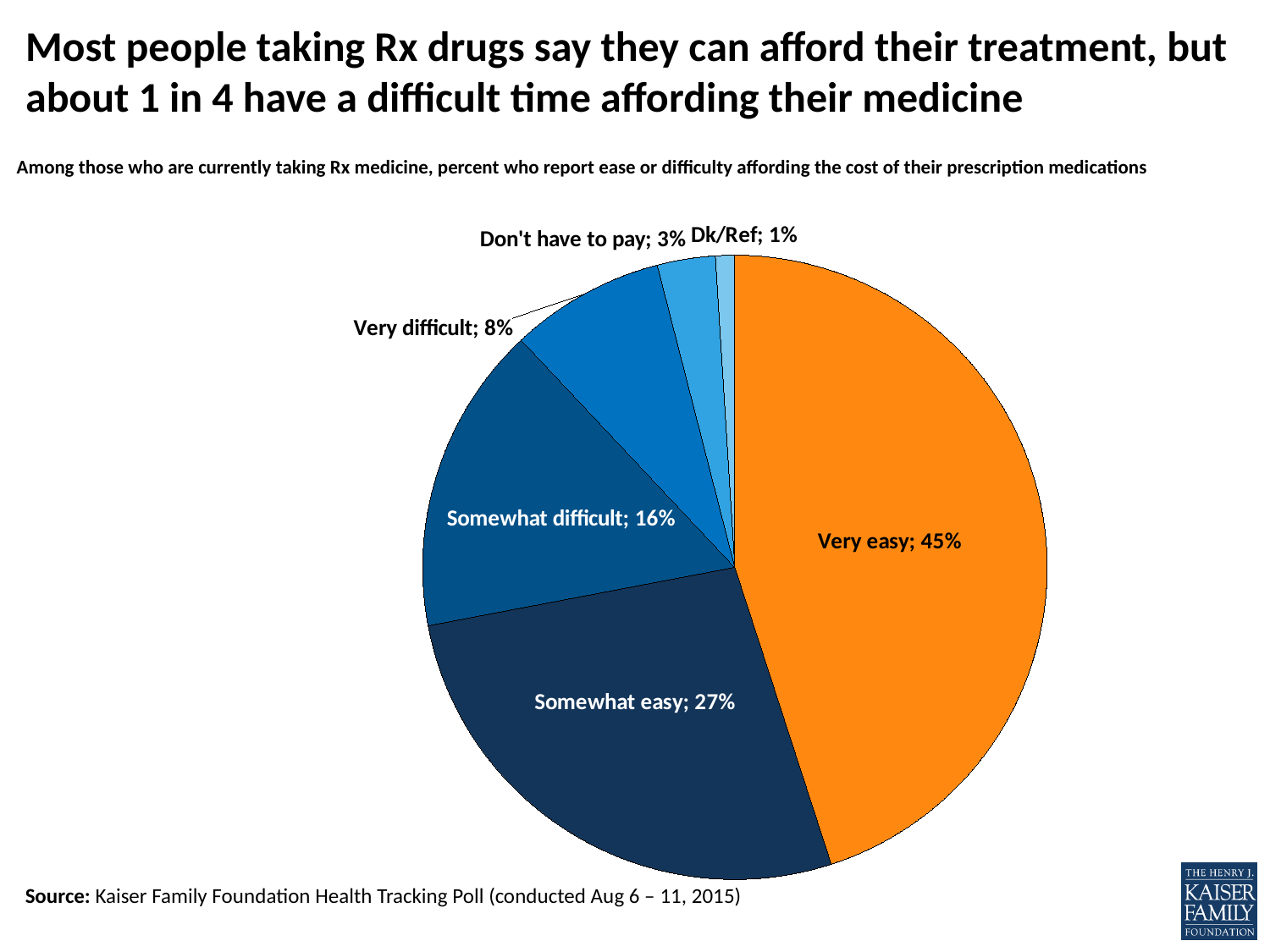
What is the combined share of the 'Somewhat difficult' and 'Very difficult' slices? 24% What is the difference in percentage points between the 'Somewhat difficult' and 'Very difficult' slices? 8 How many slices does the pie chart have? 6 Which category has the largest share of the pie? Very easy What percentage of respondents say affording their prescription medications is somewhat difficult? 16% What percentage of respondents say they don't have to pay for their prescription medications? 3% What is the difference in percentage points between the 'Very easy' and 'Somewhat easy' slices? 18 What colour is the 'Very easy' slice? Orange What percentage of respondents say affording their prescription medications is very easy? 45% Which category has the smallest share of the pie? Dk/Ref Which slice is larger: 'Somewhat easy' or 'Somewhat difficult'? Somewhat easy What kind of chart is shown on the slide? Pie chart